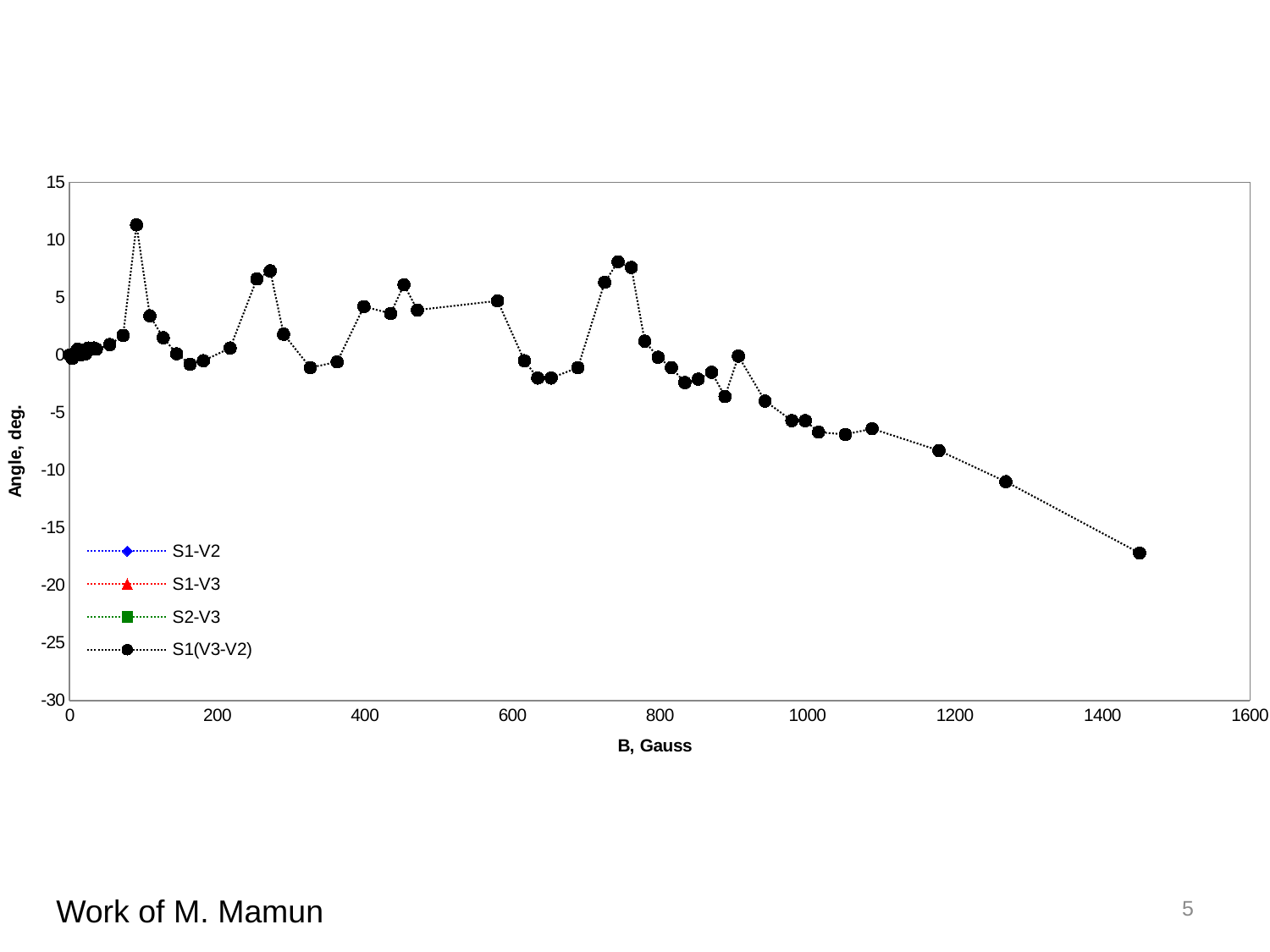
Which legend series is plotted with black circle markers? S1(V3-V2) What is the label of the x axis? B, Gauss Is the highest angle value on the chart greater or less than 10? greater Is the angle value at the last data point (around 1450 Gauss) greater or less than -15? less Is the angle value at the data point near 750 Gauss greater or less than 5? greater Do the angle values rise or fall as B increases from 1000 Gauss to 1450 Gauss? fall What kind of chart is shown on the slide? Line chart with markers (scatter plot) What is the label of the y axis? Angle, deg. How many series does the legend list? 4 Which has the larger angle value: the data point near 90 Gauss or the data point near 750 Gauss? The point near 90 Gauss What is the lowest value shown on the y axis? -30